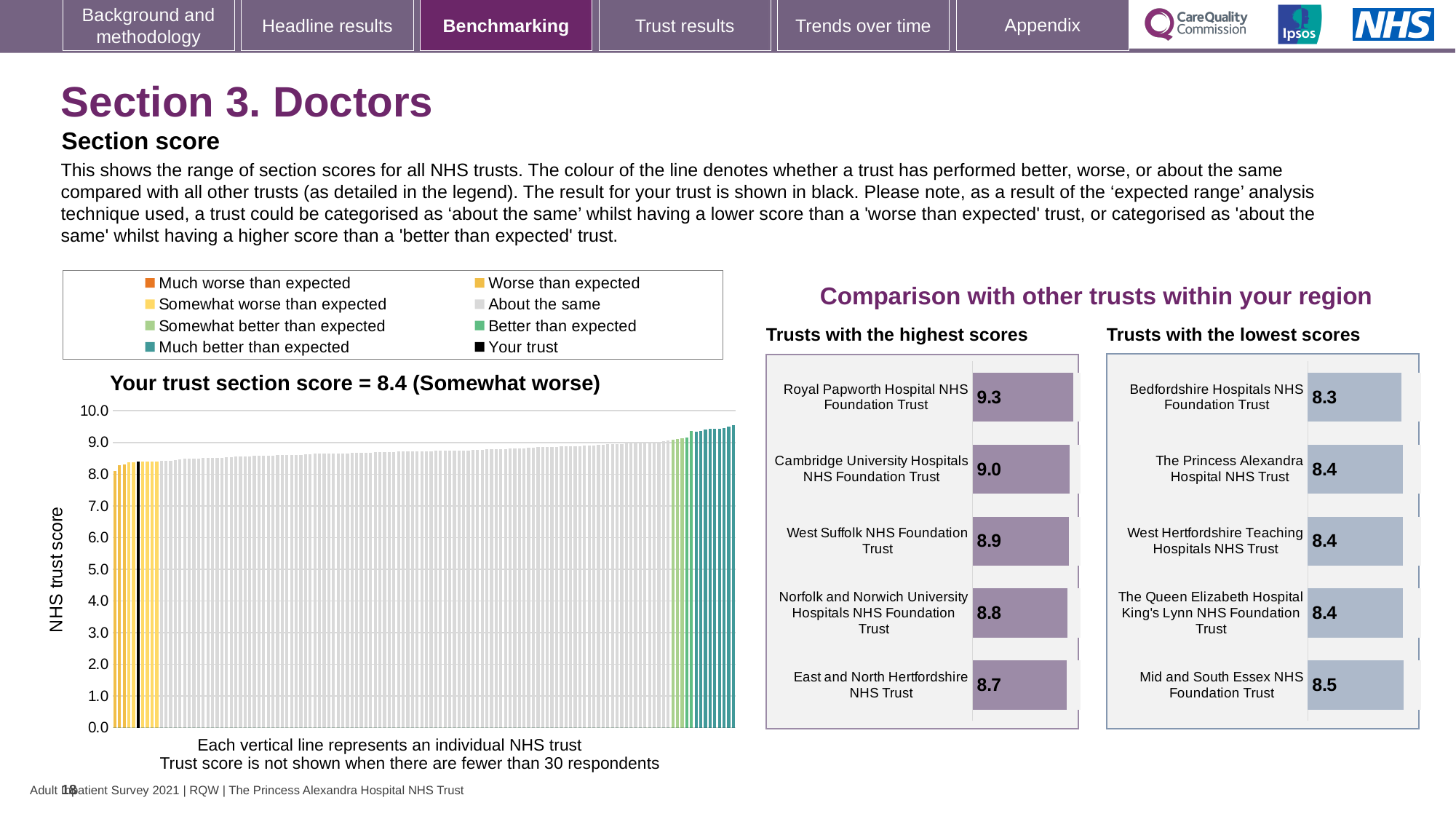
In the 'Trusts with the highest scores' chart, what is the score for Royal Papworth Hospital NHS Foundation Trust? 9.3 In the 'Trusts with the lowest scores' chart, what is the score for Mid and South Essex NHS Foundation Trust? 8.5 In the 'Trusts with the lowest scores' chart, which is larger: the score for Bedfordshire Hospitals NHS Foundation Trust or Mid and South Essex NHS Foundation Trust? Mid and South Essex NHS Foundation Trust In the 'Your trust section score' chart, do the trust scores rise or fall from left to right along the x axis? rise In the 'Your trust section score' chart, what is the section score for your trust? 8.4 What is the y-axis label of the 'Your trust section score' chart? NHS trust score How many trusts are shown in the 'Trusts with the highest scores' chart? 5 In the 'Trusts with the lowest scores' chart, which trust has the lowest score? Bedfordshire Hospitals NHS Foundation Trust In the 'Trusts with the highest scores' chart, what is the difference between the scores of Royal Papworth Hospital NHS Foundation Trust and East and North Hertfordshire NHS Trust? 0.6 In the 'Trusts with the highest scores' chart, which trust has the lowest score? East and North Hertfordshire NHS Trust What kind of chart is the 'Your trust section score' chart? bar chart How many entries does the legend above the 'Your trust section score' chart list? 8